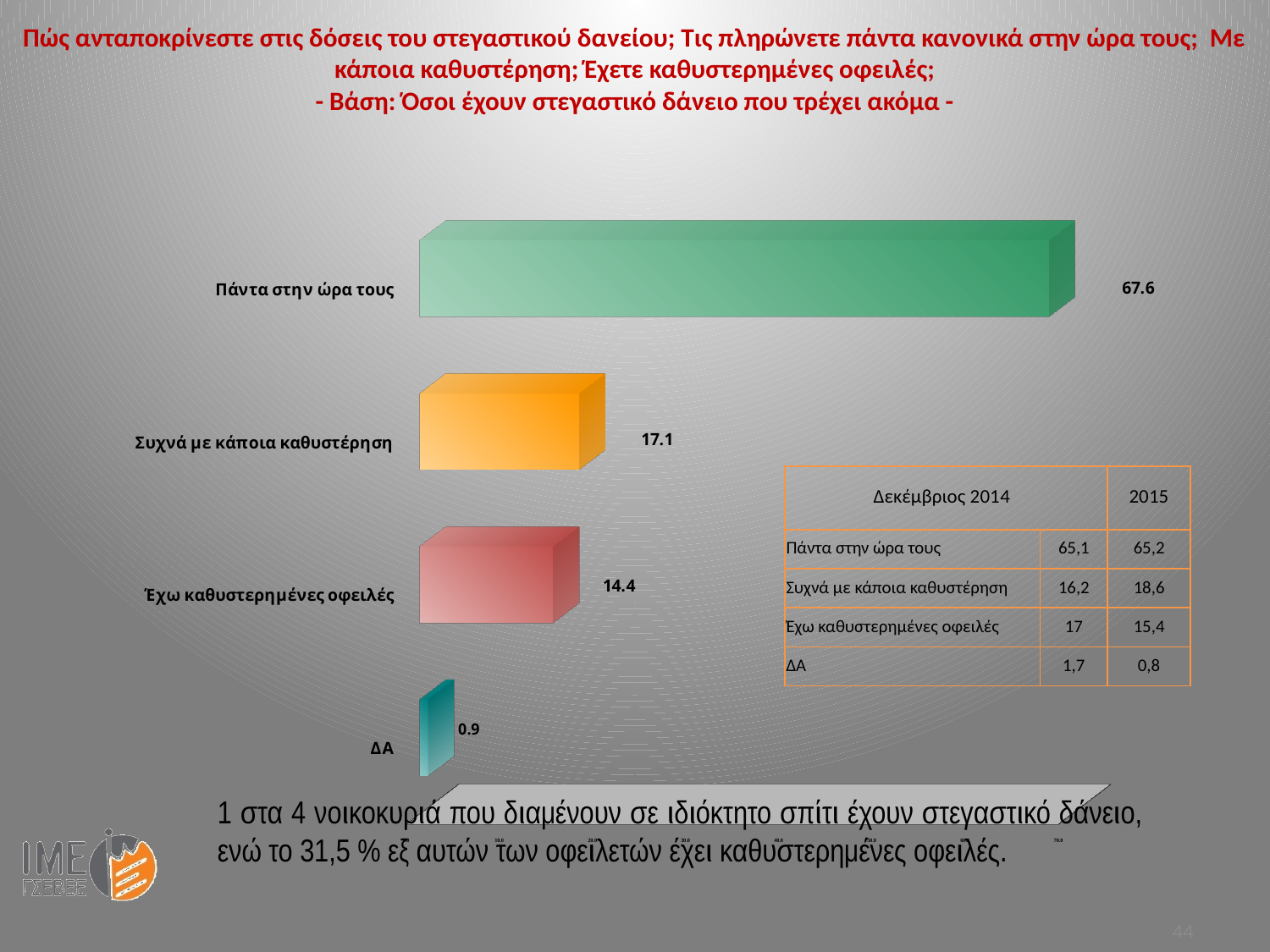
What is the value for "ΔΑ"? 0.9 What colour is the bar for "Πάντα στην ώρα τους"? Green Which category has the highest value? Πάντα στην ώρα τους What is the value for "Πάντα στην ώρα τους"? 67.6 What kind of chart is shown on the slide? Bar chart Which category has the lowest value? ΔΑ How many categories are shown in the chart? 4 Which is larger, the value for "Συχνά με κάποια καθυστέρηση" or the value for "Έχω καθυστερημένες οφειλές"? Συχνά με κάποια καθυστέρηση What is the difference between the values for "Πάντα στην ώρα τους" and "Συχνά με κάποια καθυστέρηση"? 50.5 What is the value for "Συχνά με κάποια καθυστέρηση"? 17.1 What is the value for "Έχω καθυστερημένες οφειλές"? 14.4 What is the difference between the values for "Συχνά με κάποια καθυστέρηση" and "Έχω καθυστερημένες οφειλές"? 2.7